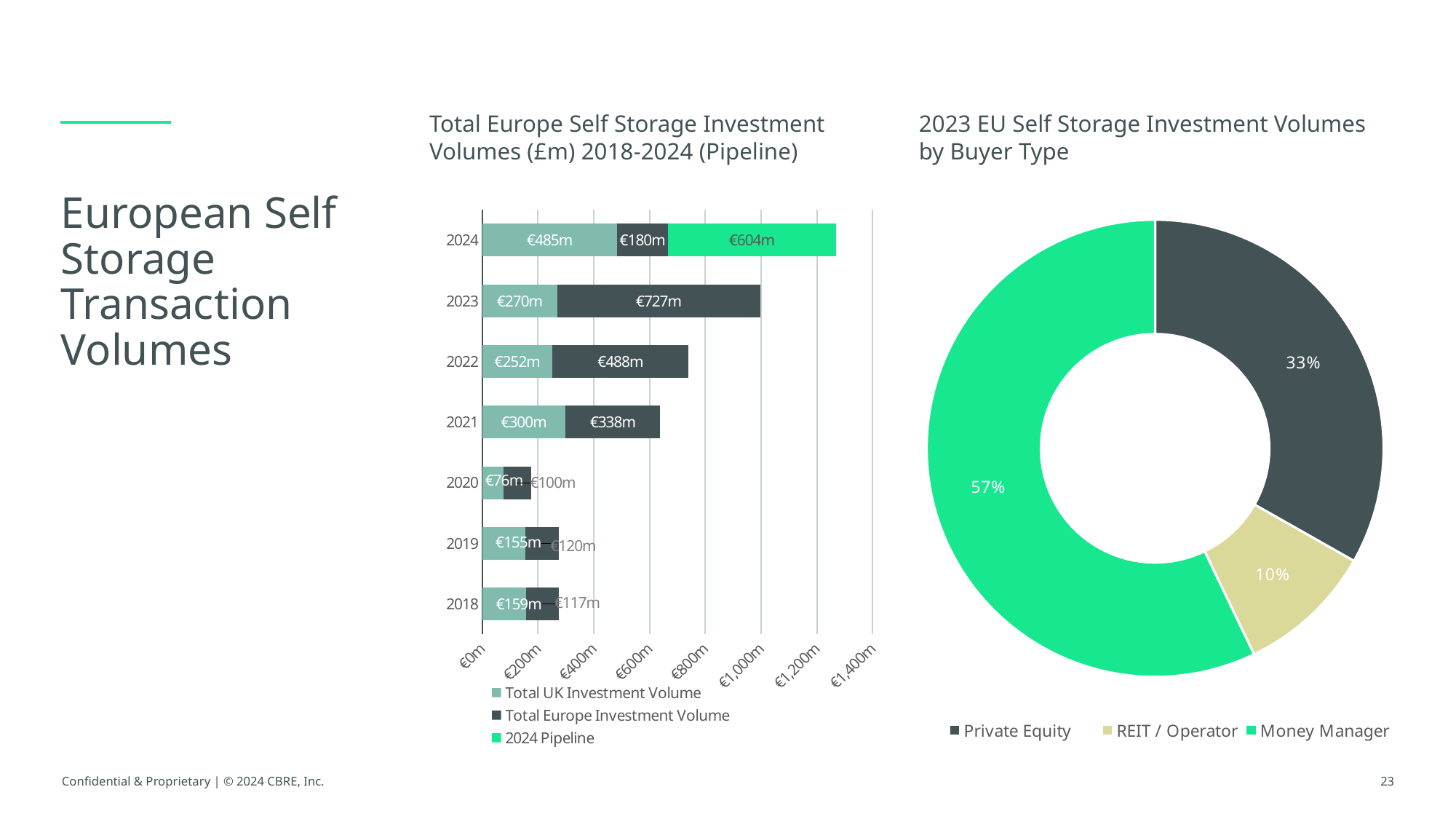
In the Total Europe Self Storage Investment Volumes chart, which year has the highest Total Europe Investment Volume? 2023 In the Total Europe Self Storage Investment Volumes chart, which year has the lowest Total UK Investment Volume? 2020 In the 2023 EU Self Storage Investment Volumes by Buyer Type chart, which buyer type has the smallest share? REIT / Operator In the Total Europe Self Storage Investment Volumes chart, what is the Total UK Investment Volume for 2021? €300m In the 2023 EU Self Storage Investment Volumes by Buyer Type chart, what share does Money Manager have? 57% In the Total Europe Self Storage Investment Volumes chart, what is the difference between the Total Europe Investment Volume in 2023 and in 2022? €239m How many series does the legend of the Total Europe Self Storage Investment Volumes chart list? 3 In the Total Europe Self Storage Investment Volumes chart, which is larger for 2019: the Total UK Investment Volume or the Total Europe Investment Volume? Total UK Investment Volume In the Total Europe Self Storage Investment Volumes chart, is the total length of the 2024 bar greater or less than €1,200m? greater In the Total Europe Self Storage Investment Volumes chart, what is the total of the stacked bar for 2023? €997m In the Total Europe Self Storage Investment Volumes chart, what is the 2024 Pipeline value? €604m In the Total Europe Self Storage Investment Volumes chart, what is the Total Europe Investment Volume for 2023? €727m